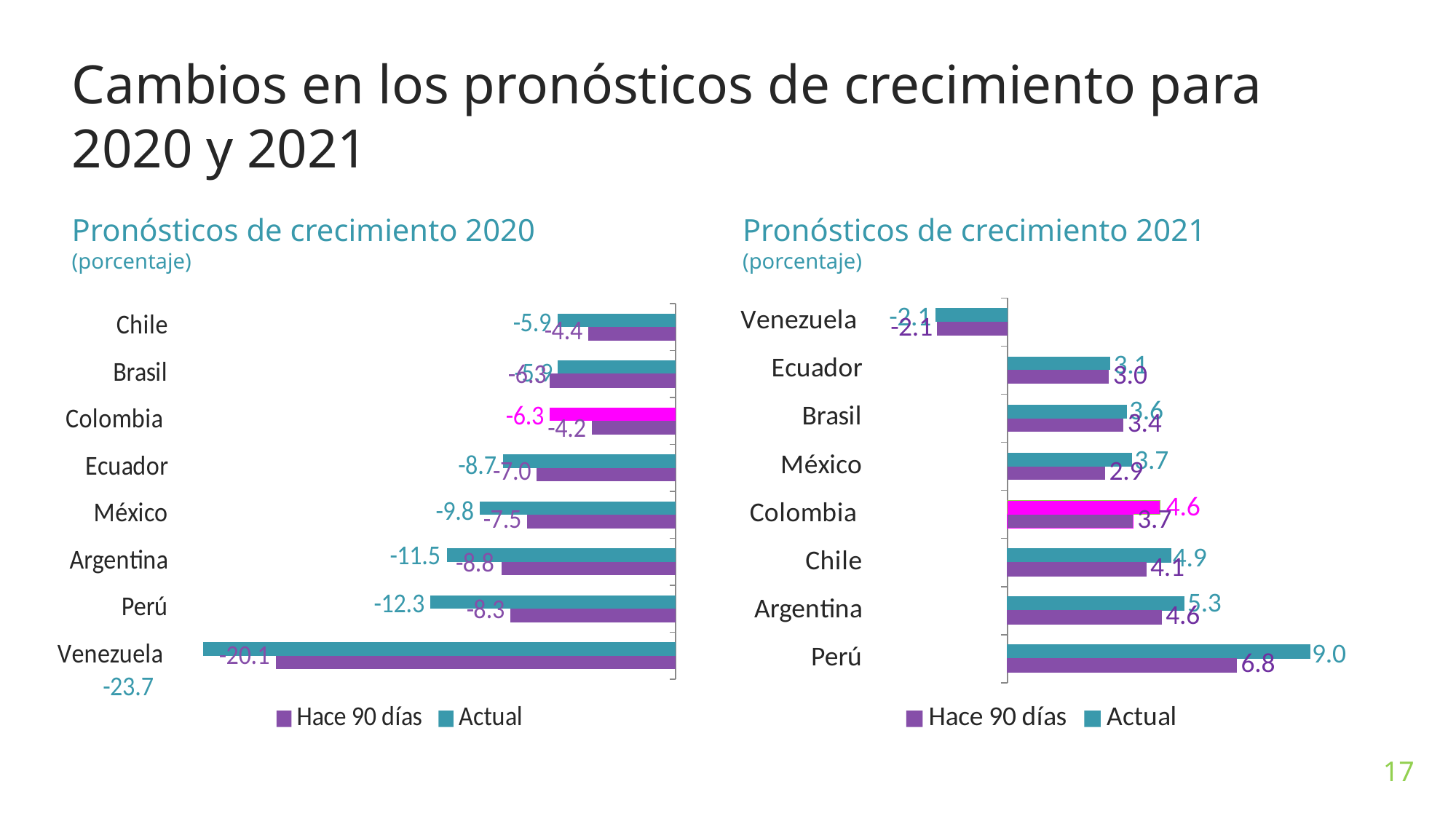
In the 'Pronósticos de crecimiento 2021' chart, which country has the highest Actual value? Perú In the 'Pronósticos de crecimiento 2020' chart, what is the Actual value for Venezuela? -23.7 In the 'Pronósticos de crecimiento 2020' chart, what is the Actual value for Colombia? -6.3 In the 'Pronósticos de crecimiento 2021' chart, which is larger: the Actual value for Argentina or the Actual value for Chile? Argentina How many series does the legend of the 'Pronósticos de crecimiento 2020' chart list? 2 In the 'Pronósticos de crecimiento 2020' chart, what is the difference between the Actual and 'Hace 90 días' values for México? 2.3 In the 'Pronósticos de crecimiento 2021' chart, what is the 'Hace 90 días' value for Colombia? 3.7 In the 'Pronósticos de crecimiento 2021' chart, what is the Actual value for Perú? 9.0 In the 'Pronósticos de crecimiento 2021' chart, what is the difference between the Actual and 'Hace 90 días' values for Perú? 2.2 In the 'Pronósticos de crecimiento 2020' chart, which country has the lowest Actual value? Venezuela In the 'Pronósticos de crecimiento 2020' chart, what is the 'Hace 90 días' value for Perú? -8.3 What type of chart is the 'Pronósticos de crecimiento 2021' chart? Bar chart